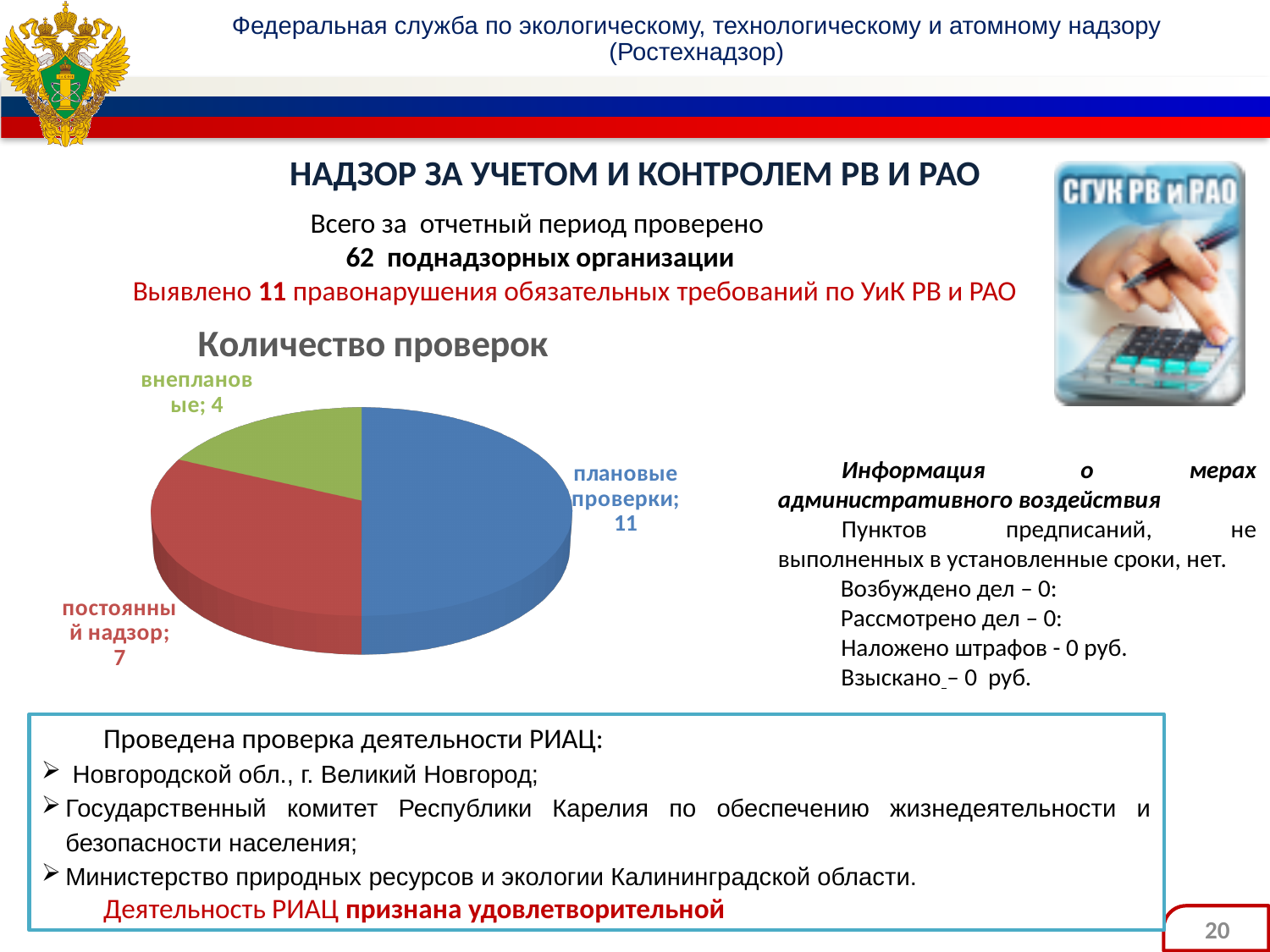
Which is larger in the pie chart: "постоянный надзор" or "внеплановые"? постоянный надзор What type of chart is shown under the title "Количество проверок"? pie chart Which category has the smallest slice in the pie chart? внеплановые What is the value for "постоянный надзор" in the pie chart? 7 What share of the pie does "плановые проверки" represent? 50% What is the value for "внеплановые" in the pie chart? 4 What is the difference between the values for "плановые проверки" and "постоянный надзор"? 4 Which category has the largest slice in the pie chart? плановые проверки What is the total of all slices in the pie chart? 22 How many categories does the pie chart show? 3 What is the title of the pie chart? Количество проверок What is the value for "плановые проверки" in the pie chart? 11